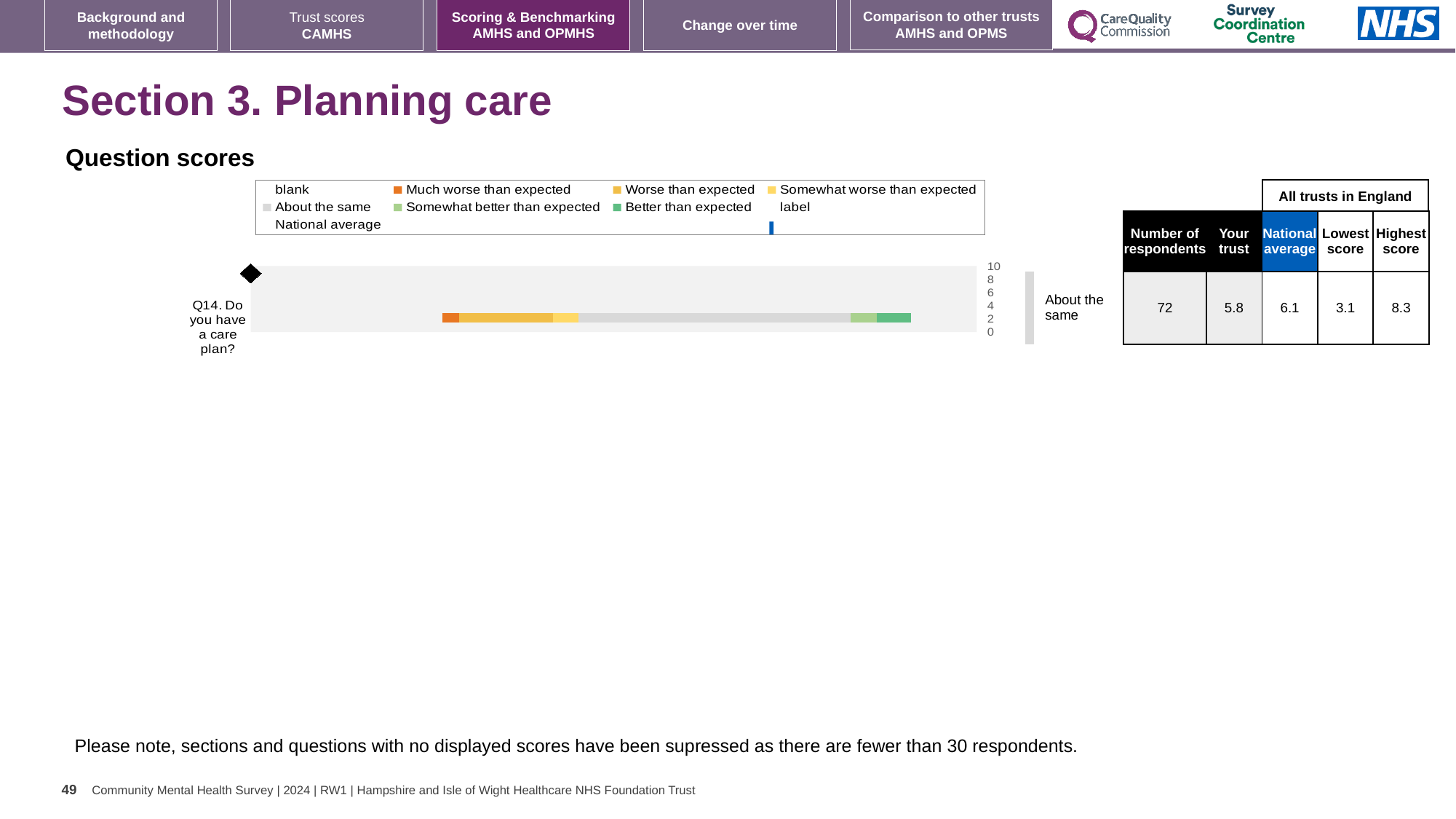
Which question is plotted in the chart? Q14. Do you have a care plan? What is the maximum value shown on the chart's score axis? 10 How many questions (categories) are plotted in the chart? 1 What is the difference between the highest score and the lowest score for Q14 in the table? 5.2 According to the table next to the chart, what is the national average for Q14? 6.1 What kind of chart is shown under 'Question scores'? bar chart According to the table next to the chart, what is the 'Your trust' score for Q14? 5.8 According to the table next to the chart, what is the highest score among all trusts in England for Q14? 8.3 Which is larger for Q14: the 'Your trust' score or the national average? National average According to the table next to the chart, what is the lowest score among all trusts in England for Q14? 3.1 What benchmark label is shown to the right of the bar for Q14? About the same According to the table next to the chart, how many respondents answered Q14? 72